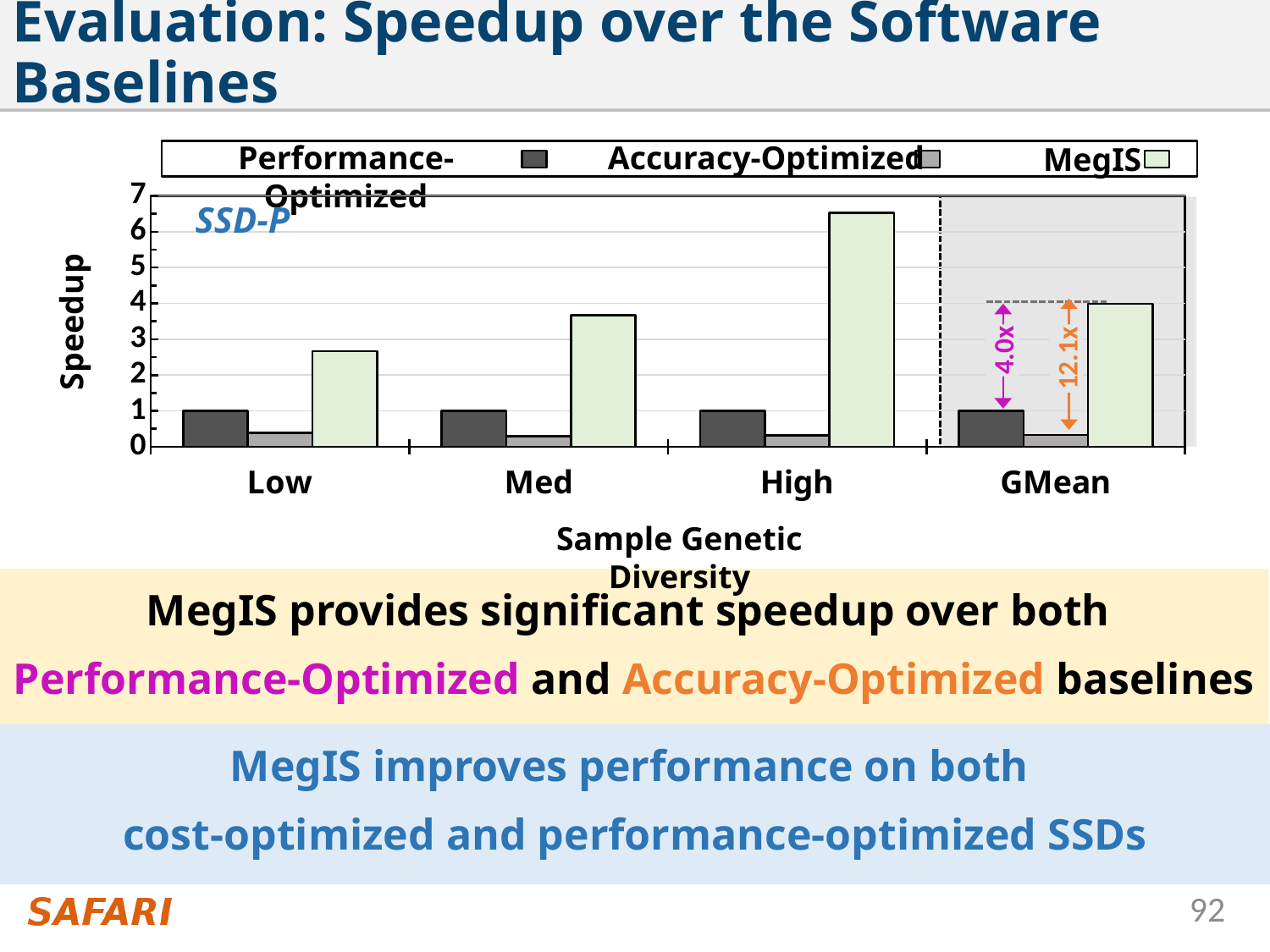
Is the MegIS speedup for High greater or less than 6? greater For High, which is larger: the MegIS speedup or the Accuracy-Optimized speedup? MegIS How many series does the legend list? 3 What kind of chart is shown on the slide? bar chart Is the MegIS speedup for Low greater or less than 3? less Do the MegIS speedups rise or fall from Low to High? rise What is the speedup of Performance-Optimized for Low? 1 What is the label of the y axis? Speedup Which category has the highest MegIS speedup? High How many categories are shown on the x axis? 4 Which category has the lowest MegIS speedup? Low What is the MegIS speedup for GMean? 4